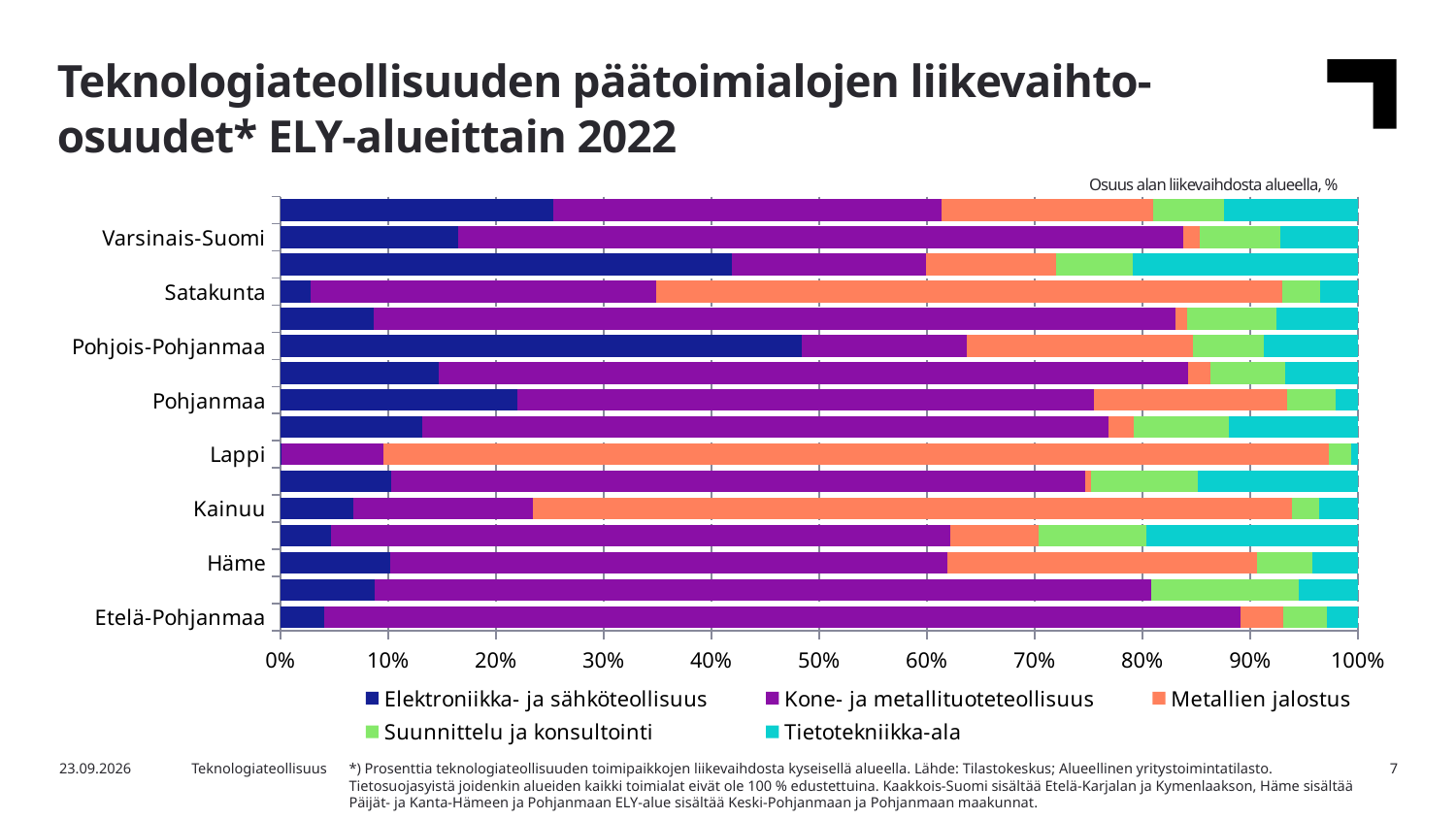
How many series does the legend list? 5 Is the Metallien jalostus share for Kainuu greater or less than 60%? greater Is the Kone- ja metallituoteteollisuus share for Etelä-Pohjanmaa greater or less than 80%? greater Which has the larger Metallien jalostus share, Lappi or Häme? Lappi Which has the larger Elektroniikka- ja sähköteollisuus share, Pohjois-Pohjanmaa or Satakunta? Pohjois-Pohjanmaa Is the Elektroniikka- ja sähköteollisuus share for Satakunta greater or less than 10%? less Which series is shown in orange in the legend? Metallien jalostus What is the title of the chart on the slide? Teknologiateollisuuden päätoimialojen liikevaihto-osuudet* ELY-alueittain 2022 What kind of chart is shown on the slide? Stacked bar chart